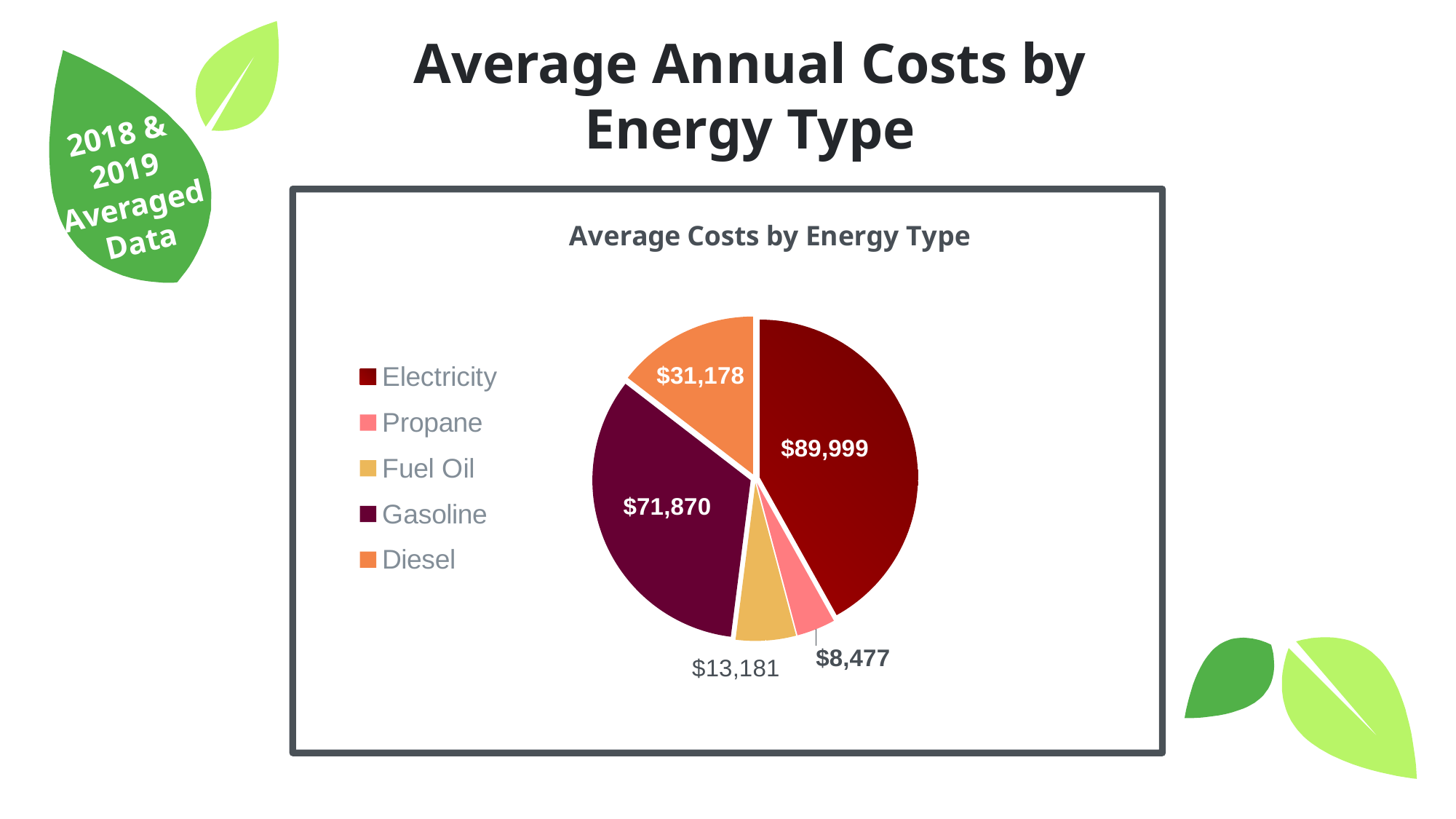
What is the average annual cost for Fuel Oil? $13,181 What is the average annual cost for Electricity? $89,999 Which energy type has the highest average annual cost? Electricity Which is larger, the cost for Fuel Oil or the cost for Propane? Fuel Oil What is the average annual cost for Propane? $8,477 How many energy types are shown in the pie chart? 5 What is the average annual cost for Diesel? $31,178 What is the average annual cost for Gasoline? $71,870 Which energy type has the lowest average annual cost? Propane What type of chart is used to show the average costs by energy type? Pie chart What is the difference between the Diesel cost and the Fuel Oil cost? $17,997 How much greater is the cost for Electricity than for Gasoline? $18,129